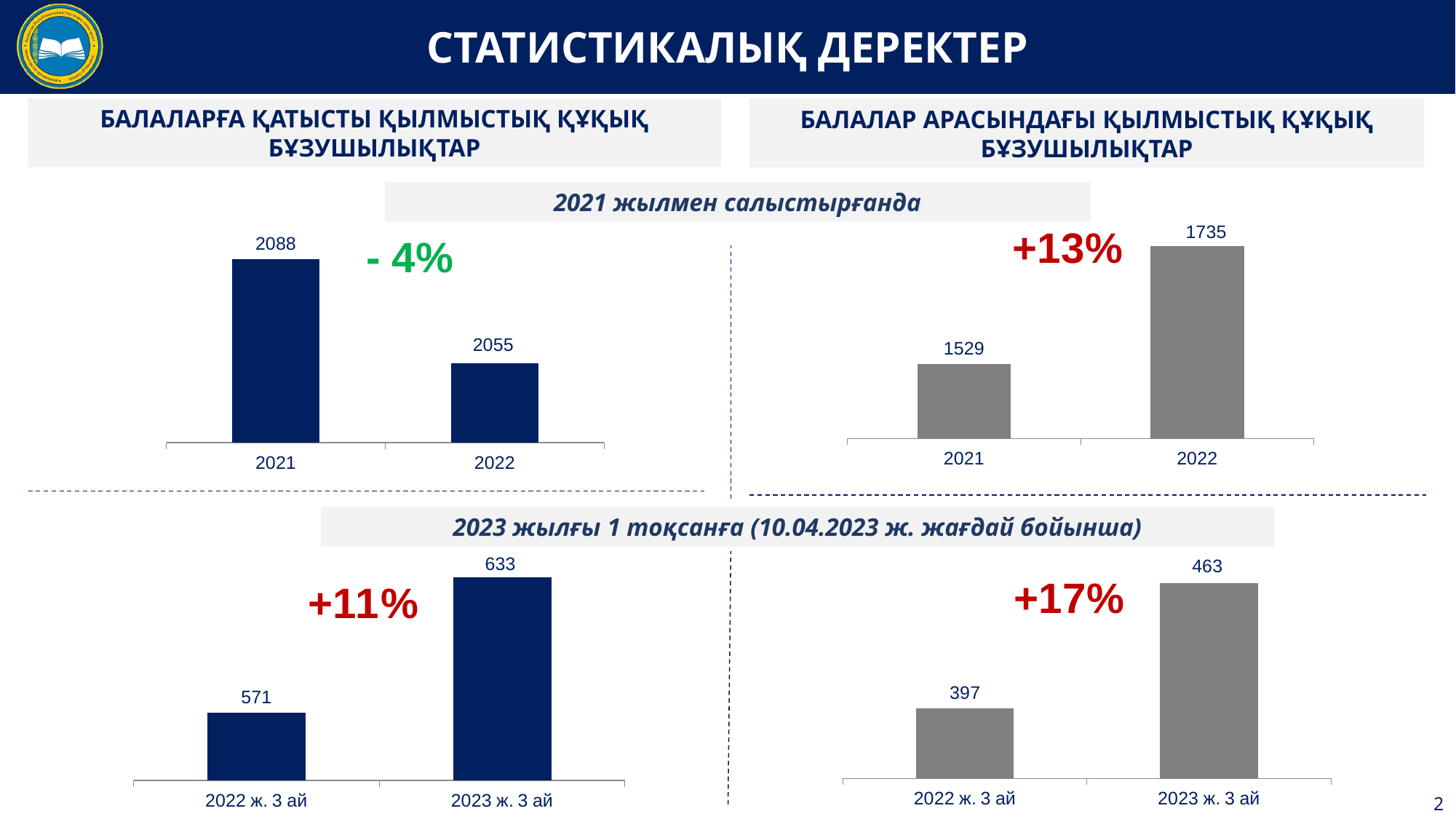
In the top-right chart, which year has the lowest value? 2021 In the top-right chart, which is larger, the value for 2021 or for 2022? 2022 In the bottom-right chart, what is the value for 2022 ж. 3 ай? 397 In the bottom-right chart, what is the difference between the 2023 ж. 3 ай and 2022 ж. 3 ай values? 66 In the top-left chart, what is the value for 2021? 2088 In the bottom-left chart, which category has the highest value? 2023 ж. 3 ай How many bars does the bottom-left chart have? 2 In the top-right chart, what is the value for 2022? 1735 In the bottom-left chart, what is the value for 2023 ж. 3 ай? 633 In the top-left chart, what is the value for 2022? 2055 What type of chart is the top-right chart? bar chart In the top-left chart, what is the difference between the 2021 and 2022 values? 33